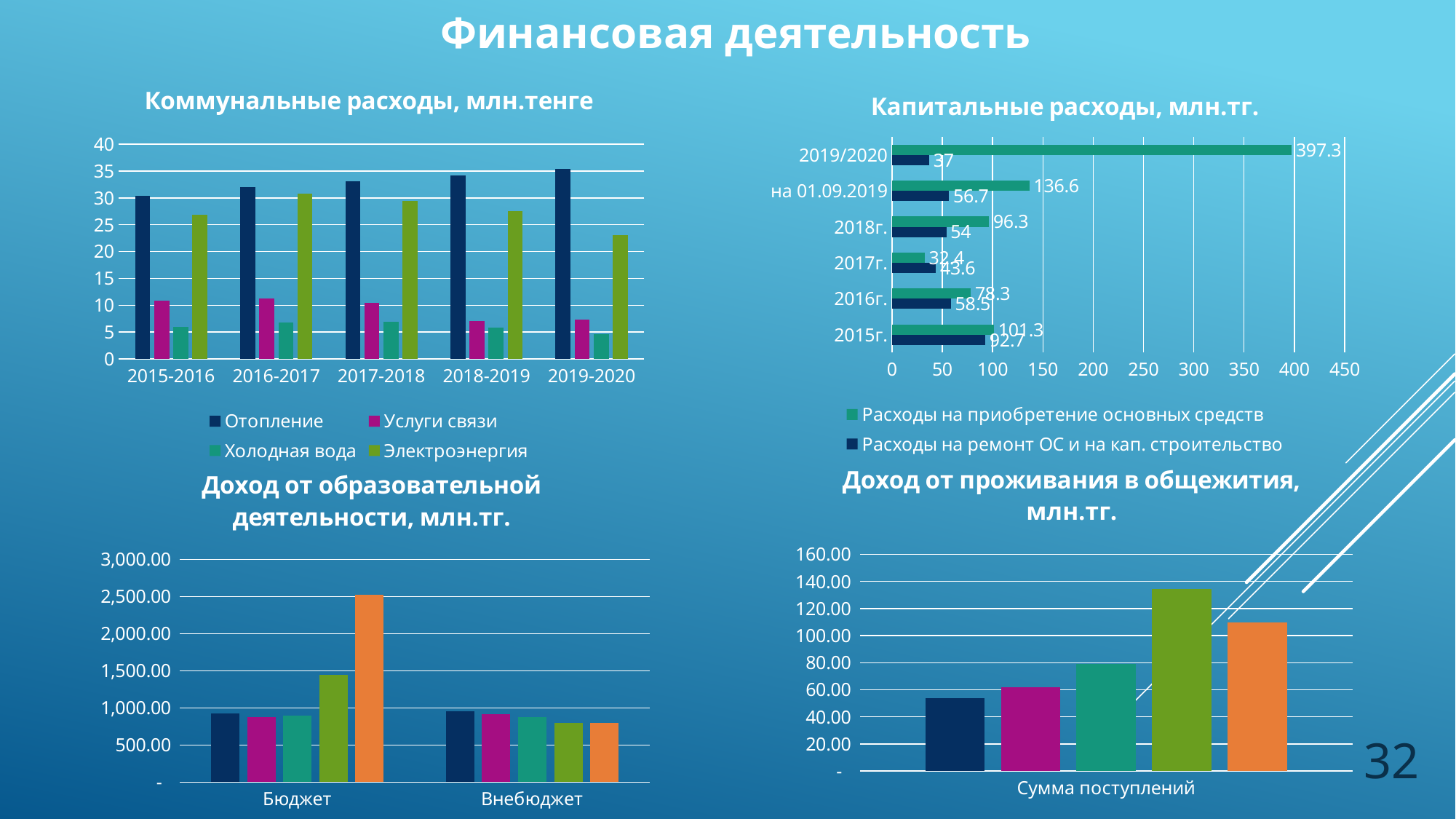
How many series does the legend of the chart 'Коммунальные расходы, млн.тенге' list? 4 How many bars are shown in the chart 'Доход от проживания в общежития, млн.тг.'? 5 In the chart 'Капитальные расходы, млн.тг.', what is the difference between the two series for 2019/2020? 360.3 In the chart 'Капитальные расходы, млн.тг.', which series has the larger value for 2017г.? Расходы на ремонт ОС и на кап. строительство In the chart 'Капитальные расходы, млн.тг.', what is the value of 'Расходы на ремонт ОС и на кап. строительство' for 2015г.? 92.7 In the chart 'Капитальные расходы, млн.тг.', what is the value of 'Расходы на приобретение основных средств' for 2019/2020? 397.3 How many series does the legend of the chart 'Капитальные расходы, млн.тг.' list? 2 In the chart 'Коммунальные расходы, млн.тенге', does the value for Отопление rise or fall from 2015-2016 to 2019-2020? rise In the chart 'Коммунальные расходы, млн.тенге', is the value for Отопление in 2019-2020 greater or less than 30? greater How many periods are shown in the chart 'Капитальные расходы, млн.тг.'? 6 What kind of chart is 'Доход от образовательной деятельности, млн.тг.'? bar chart In the chart 'Капитальные расходы, млн.тг.', which period has the lowest value for 'Расходы на приобретение основных средств'? 2017г.